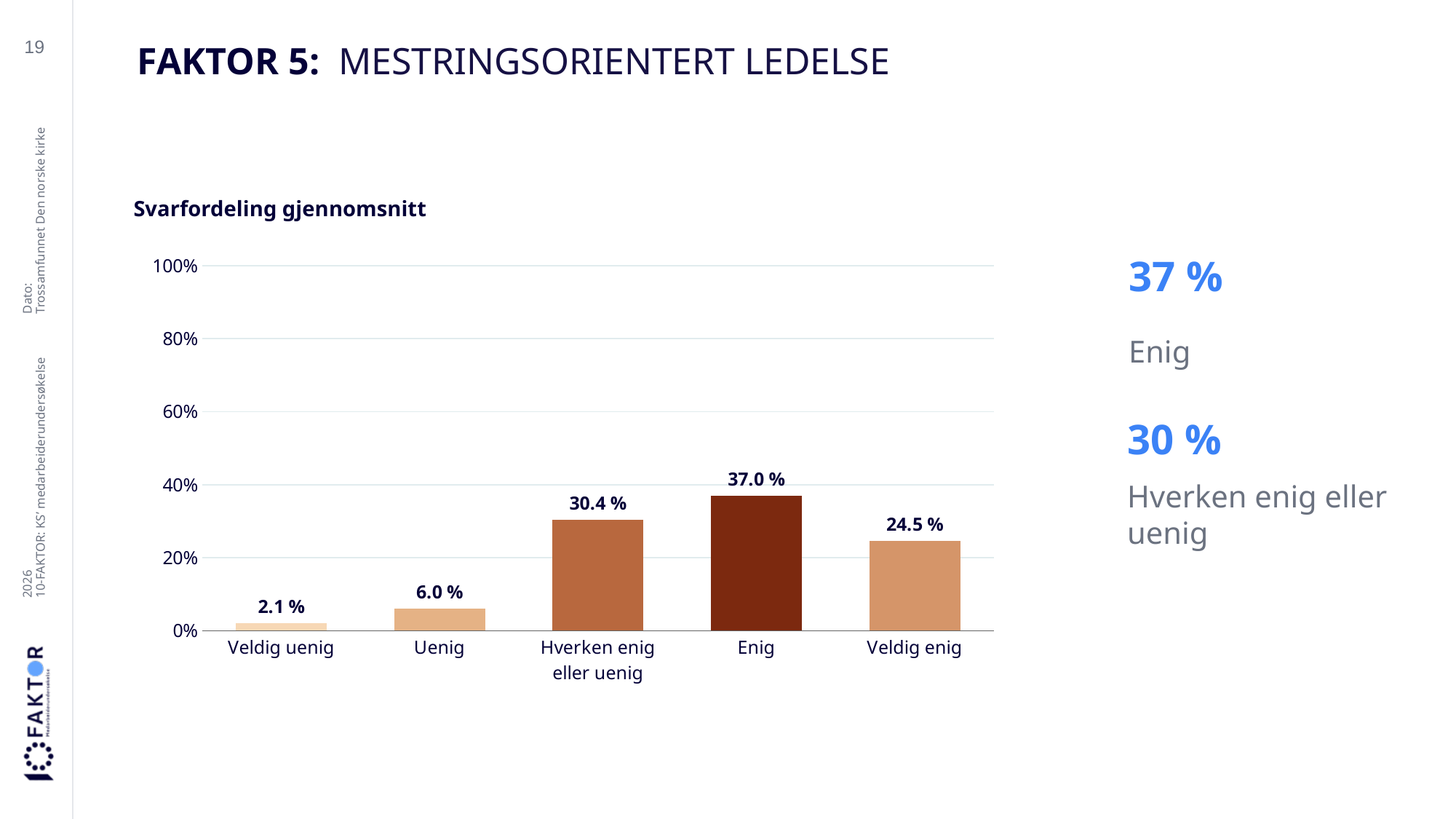
What is the difference between the values for Enig and Veldig enig? 12.5 % Which is larger, the value for Uenig or the value for Veldig enig? Veldig enig What is the value for Hverken enig eller uenig? 30.4 % What kind of chart is shown on the slide? bar chart Which category has the highest value? Enig Which category has the lowest value? Veldig uenig What is the value for Enig? 37.0 % Is the value for Hverken enig eller uenig greater or less than 20%? greater How many categories are shown on the x axis? 5 What is the value for Veldig uenig? 2.1 % What is the value for Veldig enig? 24.5 % What is the title of the chart? Svarfordeling gjennomsnitt